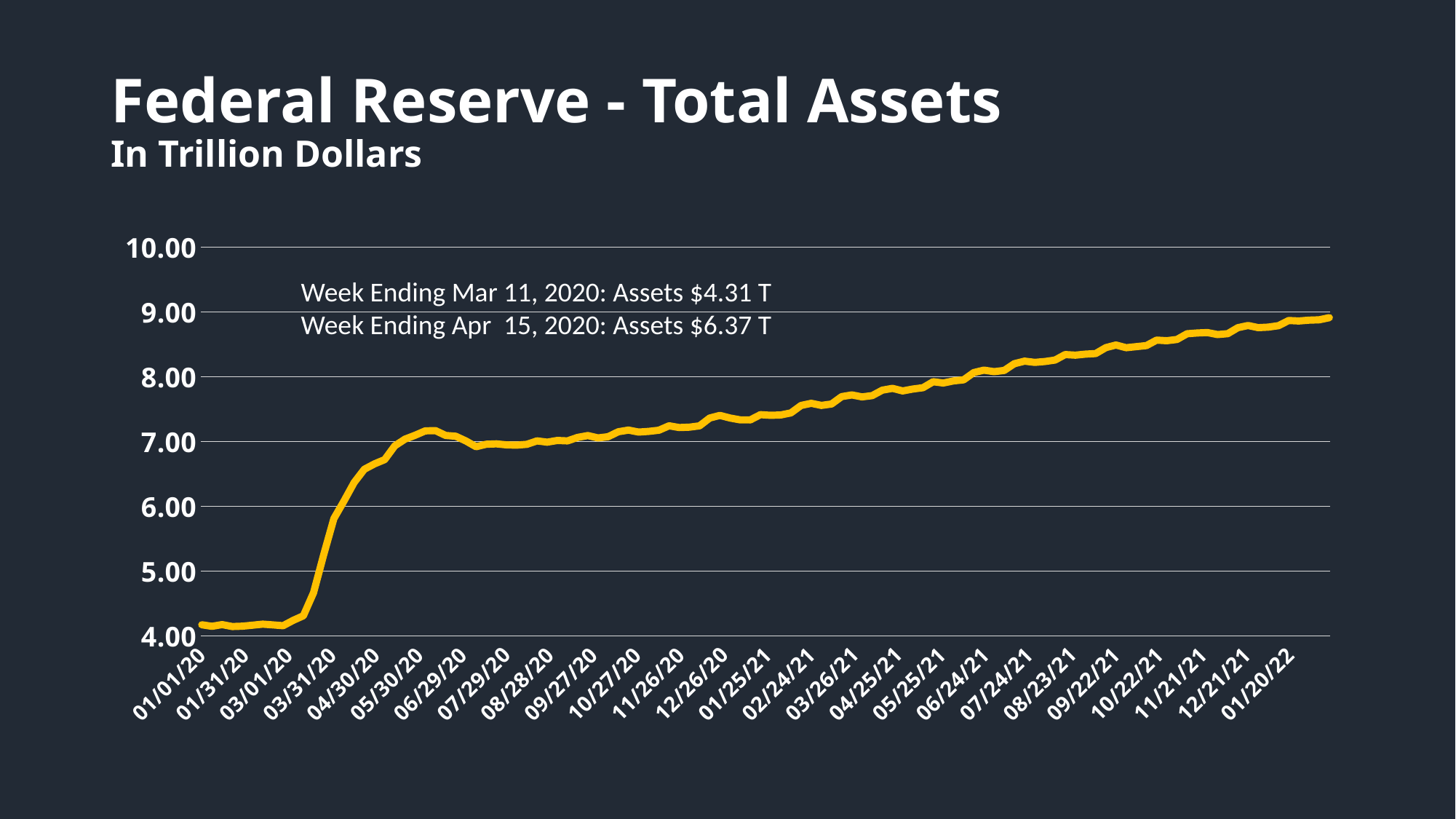
What were the Federal Reserve's total assets for the week ending Apr 15, 2020? $6.37 T Is the value at 01/01/20 greater or less than 5.00? less What is the title of the chart? Federal Reserve - Total Assets What kind of chart is shown on the slide? Line chart Which week had higher total assets: the week ending Mar 11, 2020 or the week ending Apr 15, 2020? Week ending Apr 15, 2020 In what units are the values on the chart expressed, according to the subtitle? In Trillion Dollars Is the value at 12/26/20 greater or less than 7.00? greater How many date labels are shown on the x axis? 26 Is the value at 01/20/22 greater or less than 8.00? greater Overall, do total assets rise or fall from 01/01/20 to 01/20/22? Rise By how much did total assets increase between the week ending Mar 11, 2020 and the week ending Apr 15, 2020? $2.06 T What were the Federal Reserve's total assets for the week ending Mar 11, 2020? $4.31 T